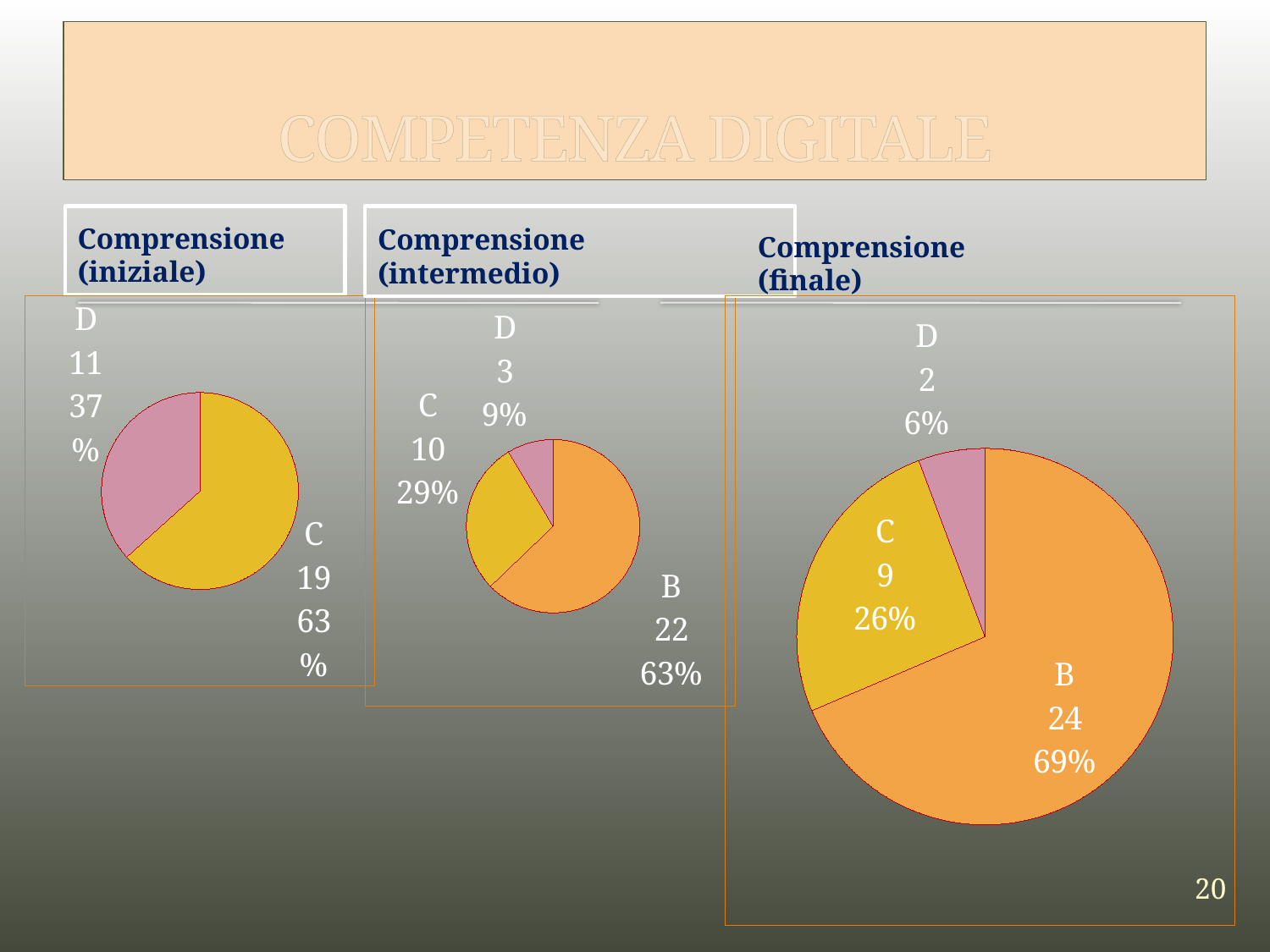
In the Comprensione (intermedio) chart, which category has the smallest slice? D How many slices does the Comprensione (iniziale) pie chart have? 2 In the Comprensione (iniziale) chart, what is the value for C? 19 In the Comprensione (iniziale) chart, what share of the pie does D have? 37% How many slices does the Comprensione (intermedio) pie chart have? 3 In the Comprensione (finale) chart, what is the difference between the values for B and D? 22 What kind of chart is used for Comprensione (iniziale)? pie chart In the Comprensione (finale) chart, what is the value for C? 9 In the Comprensione (finale) chart, which is larger, the value for C or the value for D? C In the Comprensione (intermedio) chart, what is the value for B? 22 In the Comprensione (intermedio) chart, what share of the pie does C have? 29% In the Comprensione (finale) chart, which category has the largest slice? B